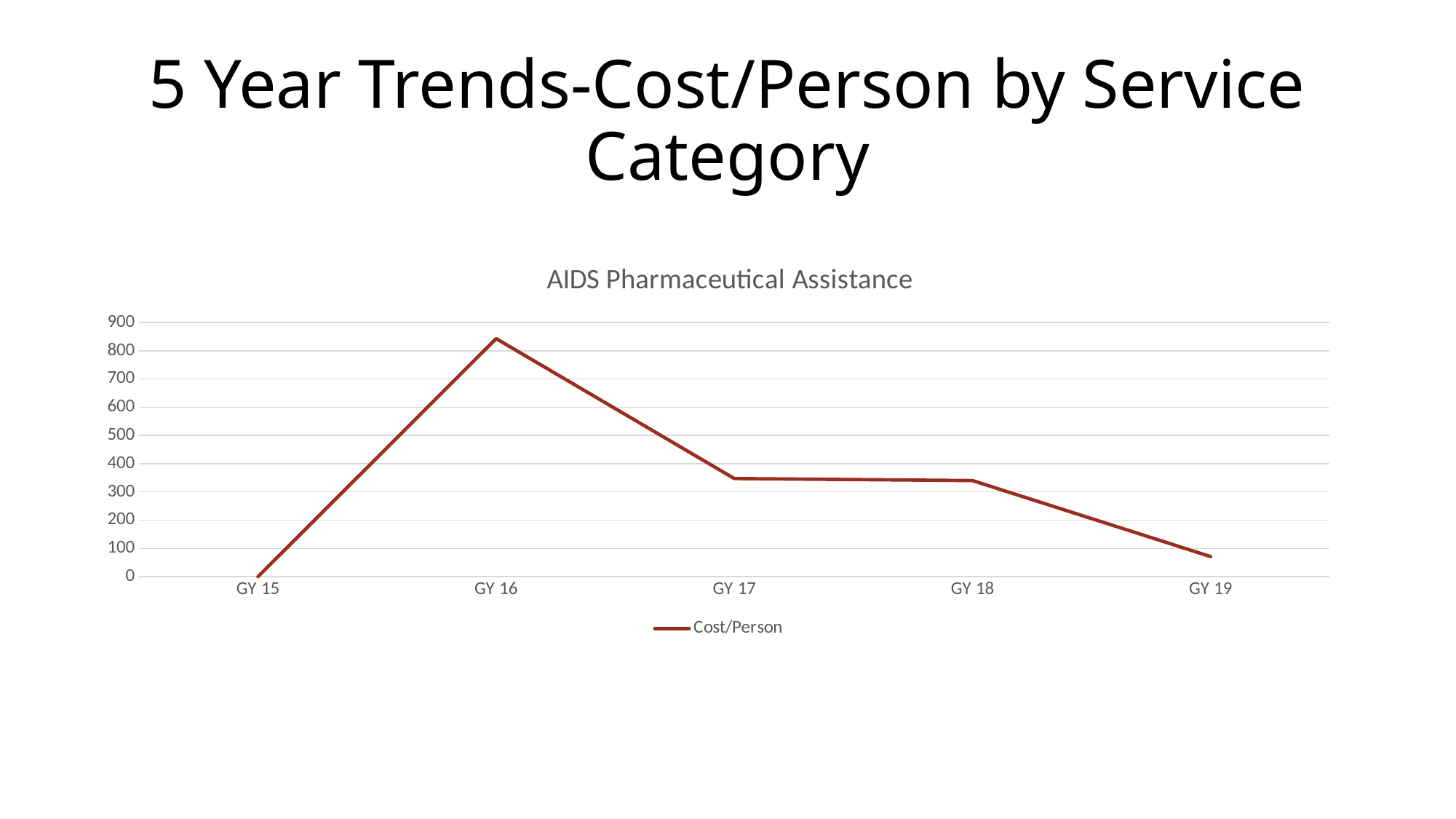
Is the Cost/Person value for GY 17 greater or less than 400? less What is the title of the chart? AIDS Pharmaceutical Assistance Does the Cost/Person rise or fall from GY 16 to GY 19? Fall Is the Cost/Person value for GY 19 greater or less than 100? less Which grant year has the lowest Cost/Person? GY 15 How many grant years are plotted on the x axis? 5 Which grant year has the highest Cost/Person? GY 16 Is the Cost/Person value for GY 16 greater or less than 800? greater How many series does the legend list? 1 What is the name of the series shown in the legend? Cost/Person What type of chart is shown on the slide? Line chart What is the Cost/Person value for GY 15? 0